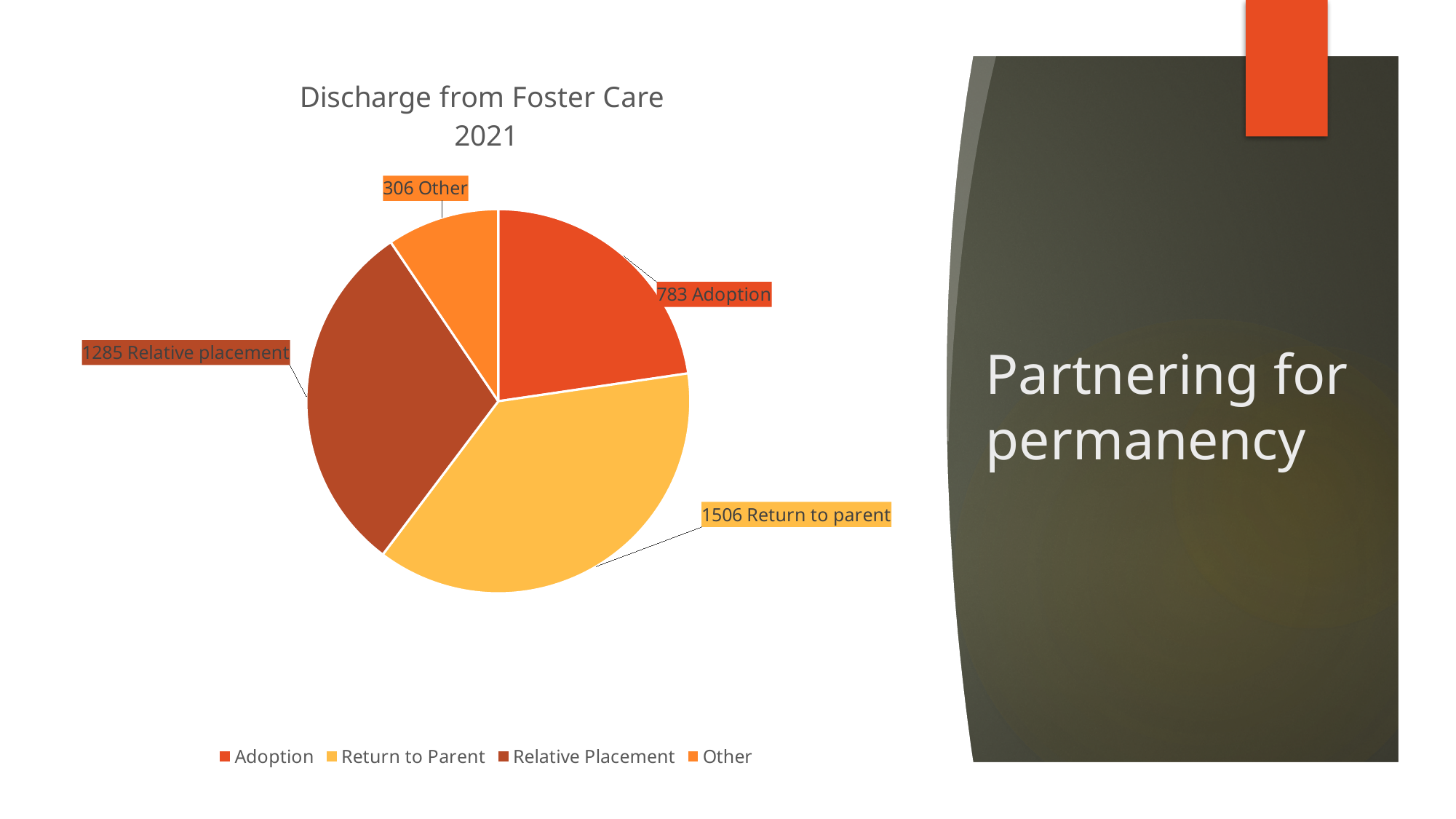
What is the title of the chart? Discharge from Foster Care 2021 What is the total of all four discharge categories? 3880 What is the difference between Return to parent and Relative placement? 221 What is the value for Return to parent? 1506 How many discharges from foster care were due to Adoption? 783 Which is larger, Adoption or Relative placement? Relative placement How many categories does the pie chart have? 4 What is the value for the Other category? 306 Which discharge category has the largest value? Return to parent What type of chart is shown on the slide? Pie chart What is the value for Relative placement? 1285 Which discharge category has the smallest value? Other